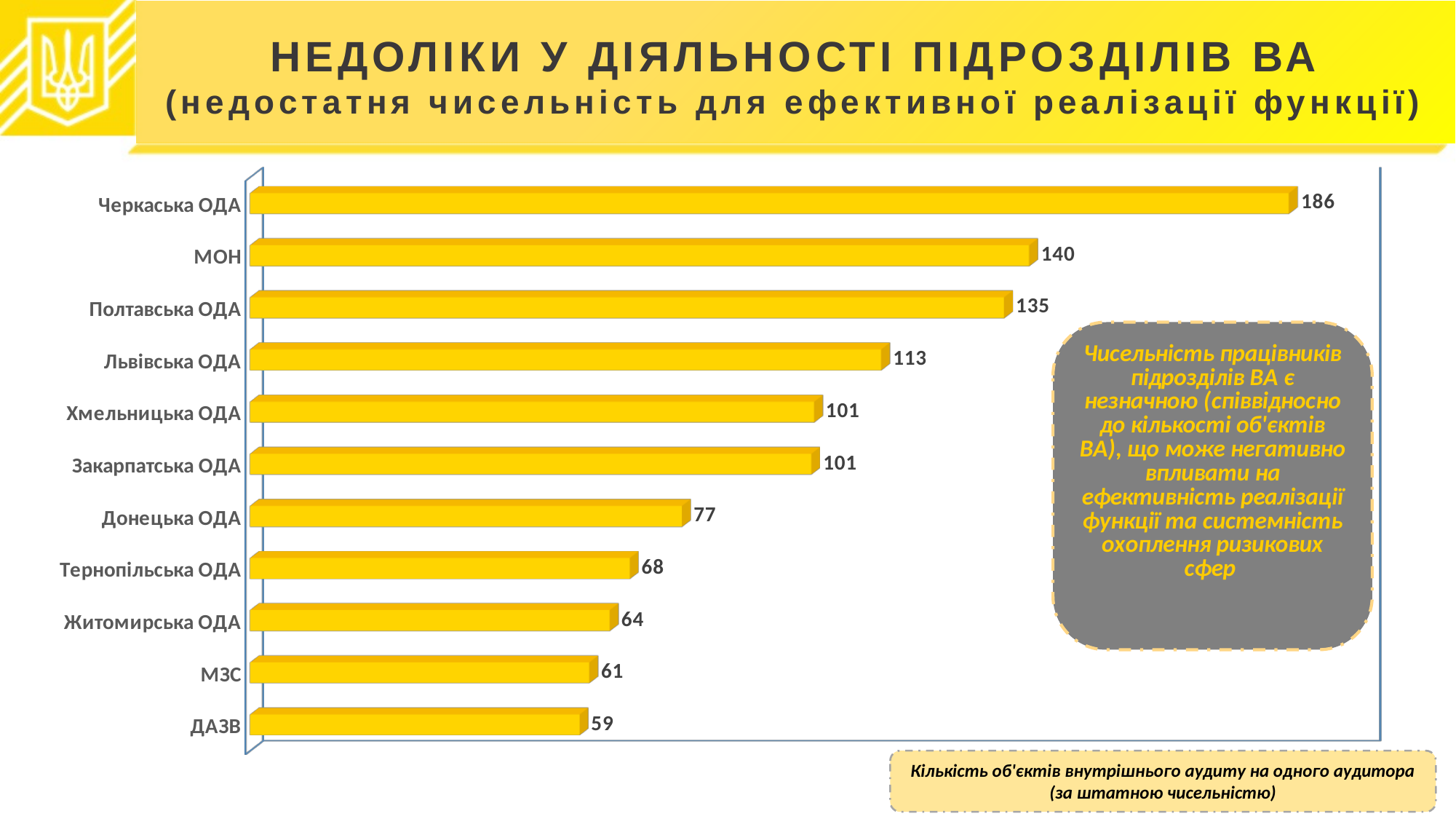
How many categories are shown in the chart? 11 What is the difference between the values for Черкаська ОДА and МОН? 46 Which is larger, the value for Тернопільська ОДА or the value for Житомирська ОДА? Тернопільська ОДА What is the value for ДАЗВ? 59 What is the value for Львівська ОДА? 113 What colour are the bars in the chart? yellow Which category has the lowest value? ДАЗВ Which category has the highest value? Черкаська ОДА What kind of chart is shown on the slide? bar chart What is the value for МОН? 140 What is the difference between the values for Полтавська ОДА and Донецька ОДА? 58 What is the value for Черкаська ОДА? 186